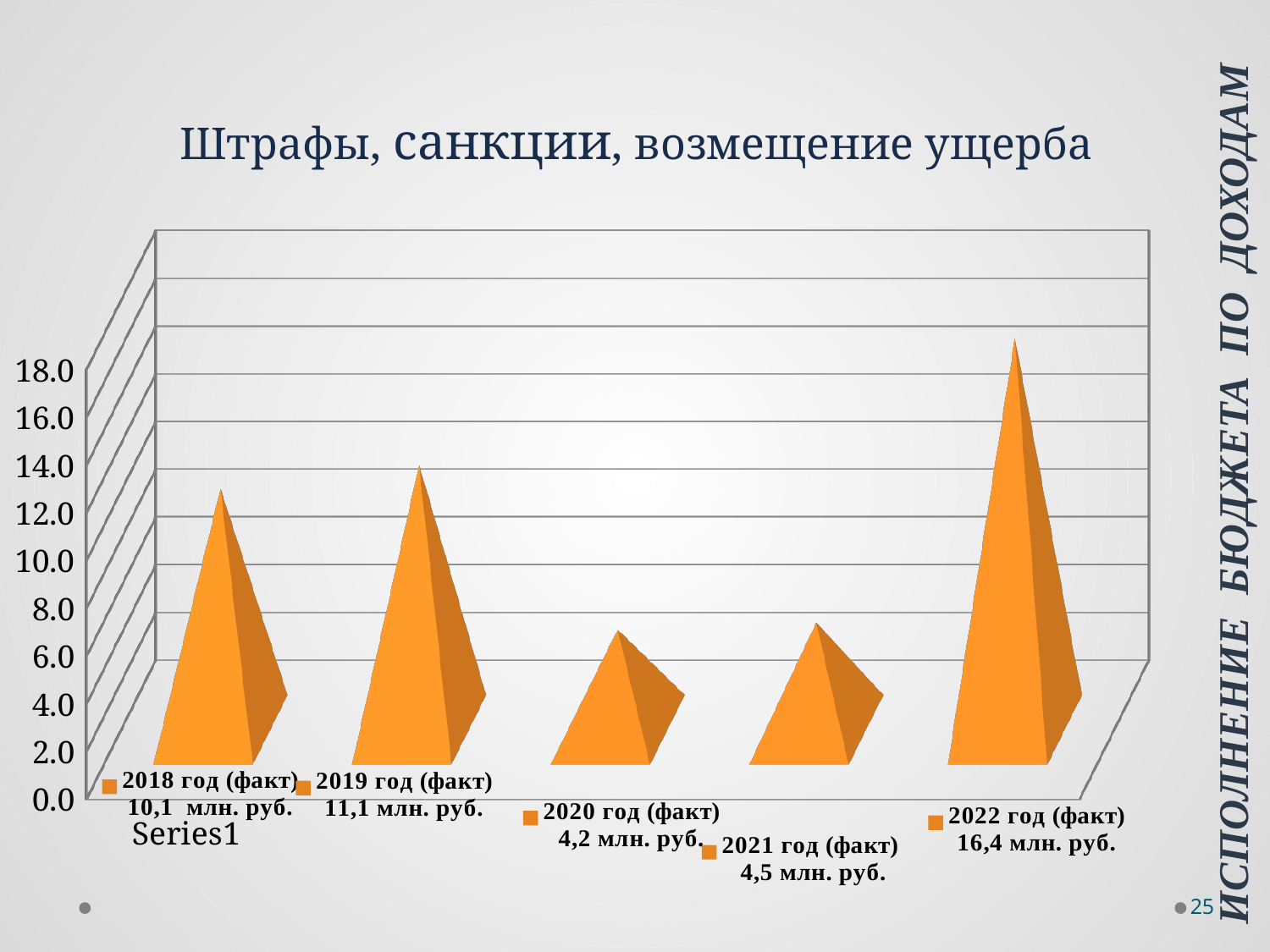
What value is shown for 2018 год (факт)? 10,1 млн. руб. What kind of chart is shown on the slide? bar chart What value is shown for 2022 год (факт)? 16,4 млн. руб. How many years are plotted on the chart? 5 What is the title of the chart? Штрафы, санкции, возмещение ущерба Which year has the highest value? 2022 год (факт) Which year has the lowest value? 2020 год (факт) Is the value for 2022 год (факт) greater or less than 14.0? greater What is the difference between the values for 2022 год (факт) and 2018 год (факт)? 6,3 млн. руб. What is the difference between the values for 2021 год (факт) and 2020 год (факт)? 0,3 млн. руб. What value is shown for 2020 год (факт)? 4,2 млн. руб. Which is larger, the value for 2019 год (факт) or 2018 год (факт)? 2019 год (факт)